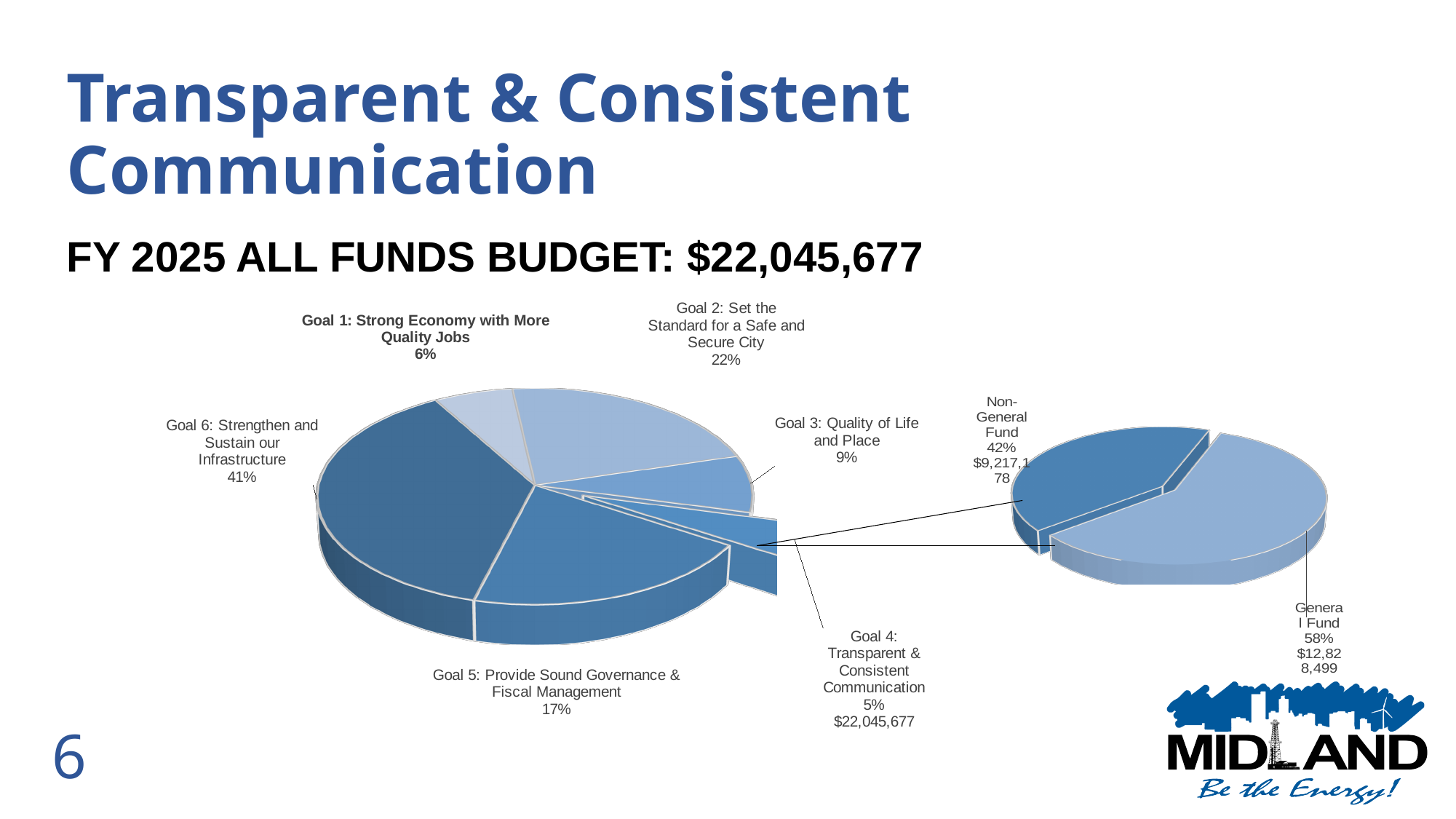
On the left pie chart, what share does Goal 6: Strengthen and Sustain our Infrastructure have? 41% On the left pie chart, which goal has the smallest share? Goal 4: Transparent & Consistent Communication On the left pie chart, what dollar amount is shown for Goal 4: Transparent & Consistent Communication? $22,045,677 On the left pie chart, which is larger, the share for Goal 3: Quality of Life and Place or Goal 1: Strong Economy with More Quality Jobs? Goal 3: Quality of Life and Place On the left pie chart, what is the difference in percentage points between Goal 2 and Goal 5? 5 On the right pie chart, what dollar amount is shown for the General Fund? $12,828,499 What kind of chart is the chart on the right of the slide? Pie chart On the left pie chart, what share does Goal 2: Set the Standard for a Safe and Secure City have? 22% On the right pie chart, what share does the Non-General Fund have? 42% On the left pie chart, how many slices (goals) are there? 6 On the left pie chart, which goal has the largest share? Goal 6: Strengthen and Sustain our Infrastructure